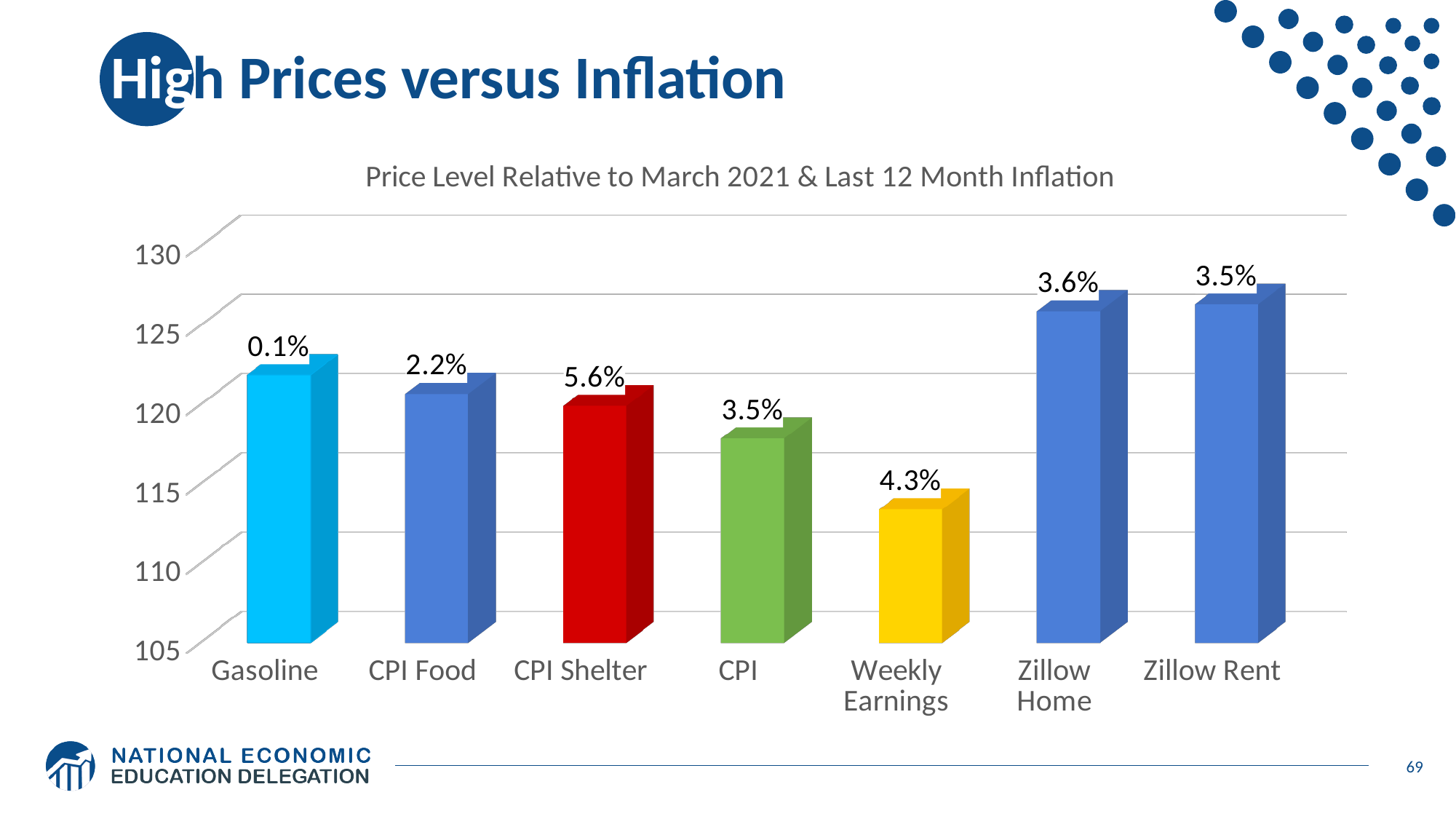
What inflation percentage is labelled above the Gasoline bar? 0.1% What inflation percentage is labelled above the CPI Shelter bar? 5.6% Which category has the highest last-12-month inflation label? CPI Shelter Which category has the lowest last-12-month inflation label? Gasoline Is the price level bar for Zillow Home greater or less than 125? greater Is the price level bar for Weekly Earnings greater or less than 115? less What inflation percentage is labelled above the Zillow Home bar? 3.6% What is the title of the chart? Price Level Relative to March 2021 & Last 12 Month Inflation Which has the larger inflation label, Zillow Home or Zillow Rent? Zillow Home How many categories are shown on the x axis? 7 Which category has the shortest bar (lowest price level relative to March 2021)? Weekly Earnings What inflation percentage is labelled above the Weekly Earnings bar? 4.3%